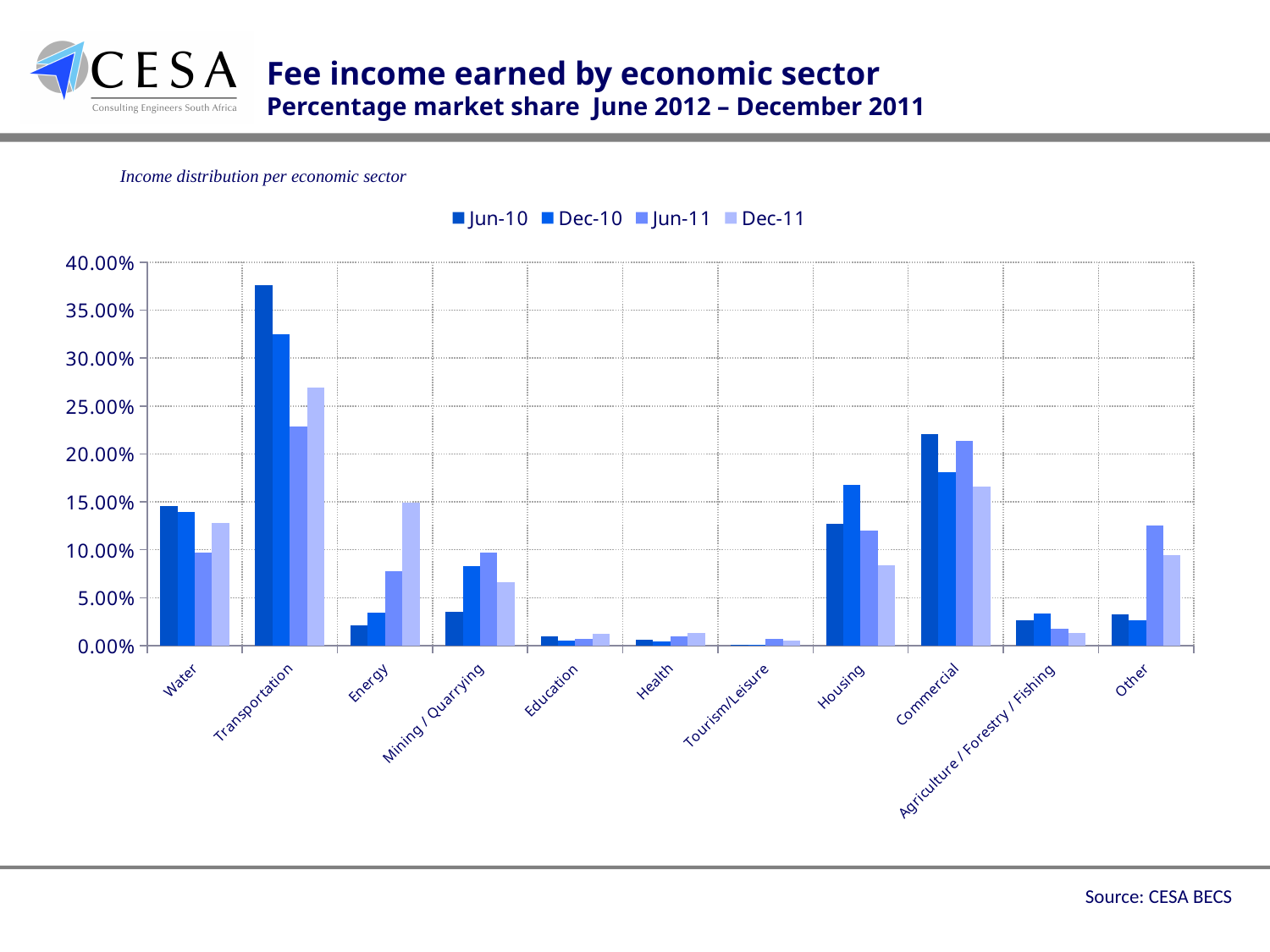
Which economic sector has the lowest Jun-10 value? Tourism/Leisure Which economic sector has the highest Jun-10 value? Transportation How many economic sectors are shown on the x axis? 11 Is the Dec-11 value for Transportation greater or less than 25.00%? greater What is the title printed above the chart? Income distribution per economic sector How many series does the legend list? 4 What kind of chart is shown on the slide? bar chart Which is larger for Jun-11: Commercial or Housing? Commercial Is the Jun-10 value for Commercial greater or less than 20.00%? greater Do the Transportation values rise or fall from Jun-10 to Dec-11? fall Is the Jun-10 value for Transportation greater or less than 35.00%? greater